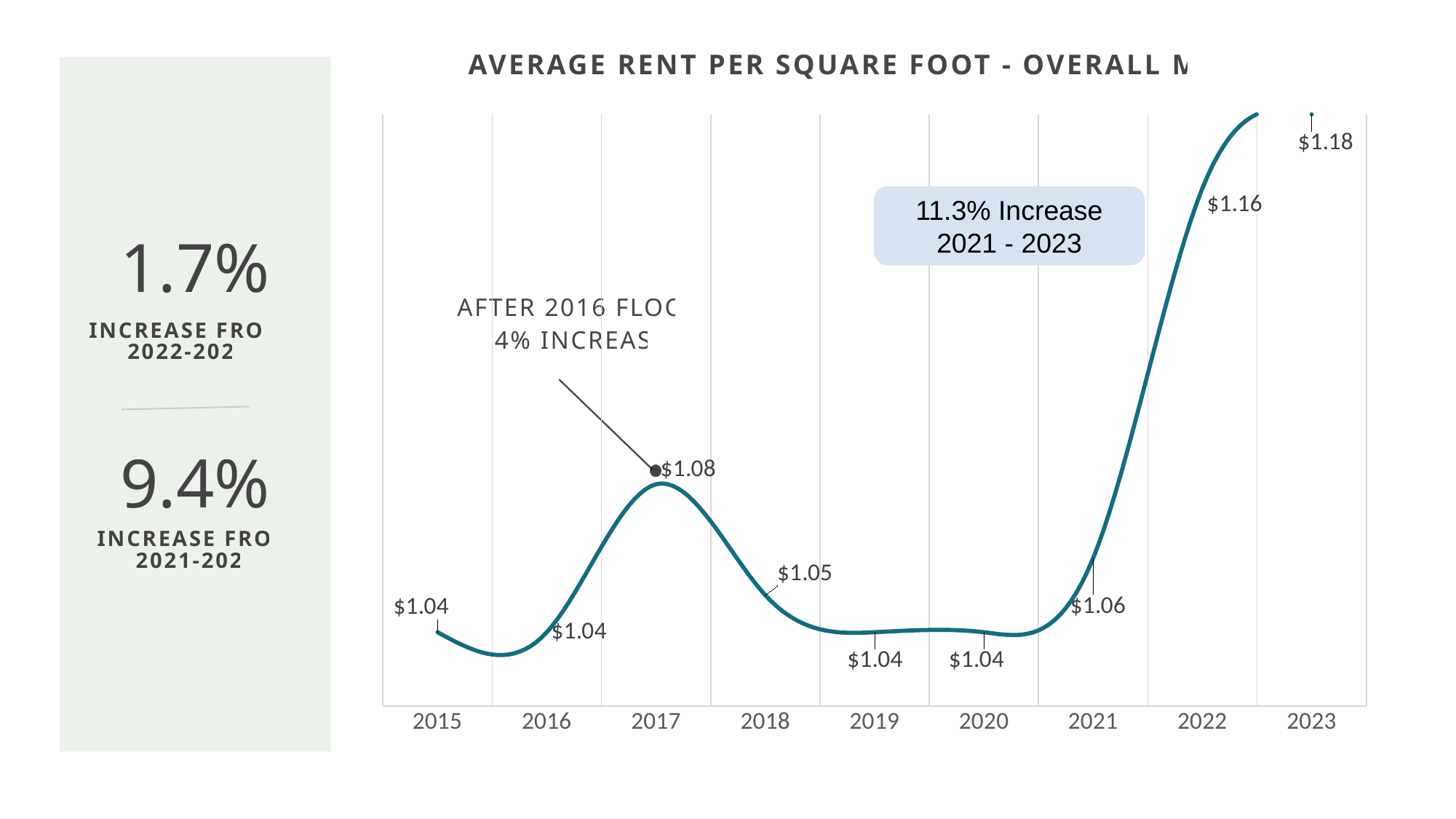
What is the average rent per square foot in 2017? $1.08 Which year has the highest average rent per square foot? 2023 What kind of chart is shown on the slide? Line chart Does the average rent per square foot rise or fall from 2021 to 2023? Rise Which year has the higher average rent per square foot, 2022 or 2018? 2022 What is the difference in average rent per square foot between 2023 and 2021? $0.12 What is the difference in average rent per square foot between 2017 and 2016? $0.04 What is the average rent per square foot in 2023? $1.18 What percentage increase does the callout box on the chart state for 2021 - 2023? 11.3% What is the average rent per square foot in 2021? $1.06 How many years are plotted on the x axis? 9 What is the average rent per square foot in 2018? $1.05